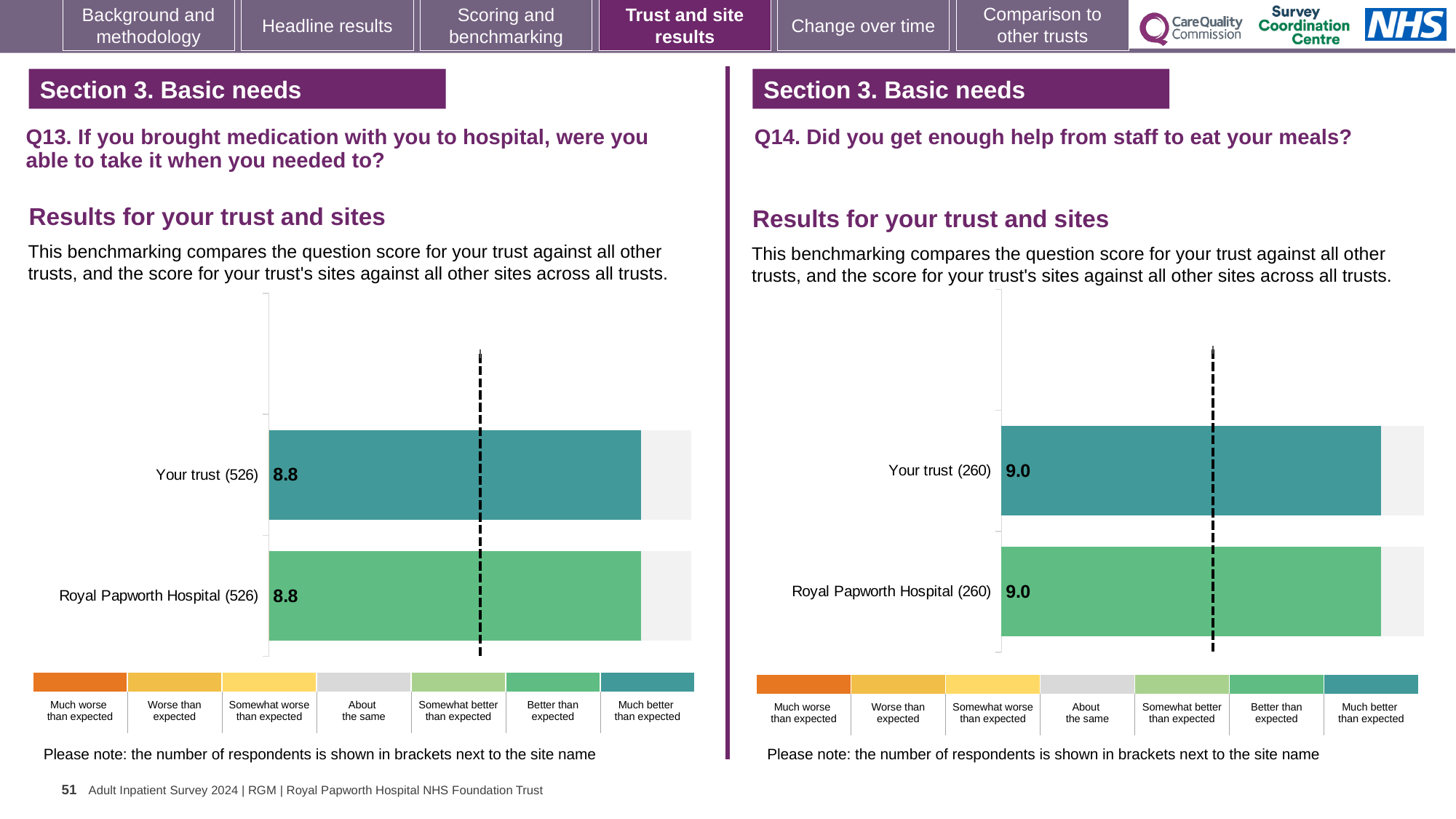
How many bars are plotted in the Q14 chart on the right? 2 In the Q13 chart on the left, what is the score for Your trust? 8.8 In the Q13 chart on the left, what is the difference between the score for Your trust and the score for Royal Papworth Hospital? 0.0 In the Q14 chart on the right, what is the score for Your trust? 9.0 In the Q13 chart on the left, how many respondents are shown in brackets next to Your trust? 526 In the Q13 chart on the left, what is the score for Royal Papworth Hospital? 8.8 In the Q14 chart on the right, what is the difference between the score for Your trust and the score for Royal Papworth Hospital? 0.0 How many bars are plotted in the Q13 chart on the left? 2 In the Q14 chart on the right, how many respondents are shown in brackets next to Royal Papworth Hospital? 260 What kind of chart is used for the Q13 results on the left? Bar chart In the Q14 chart on the right, what is the score for Royal Papworth Hospital? 9.0